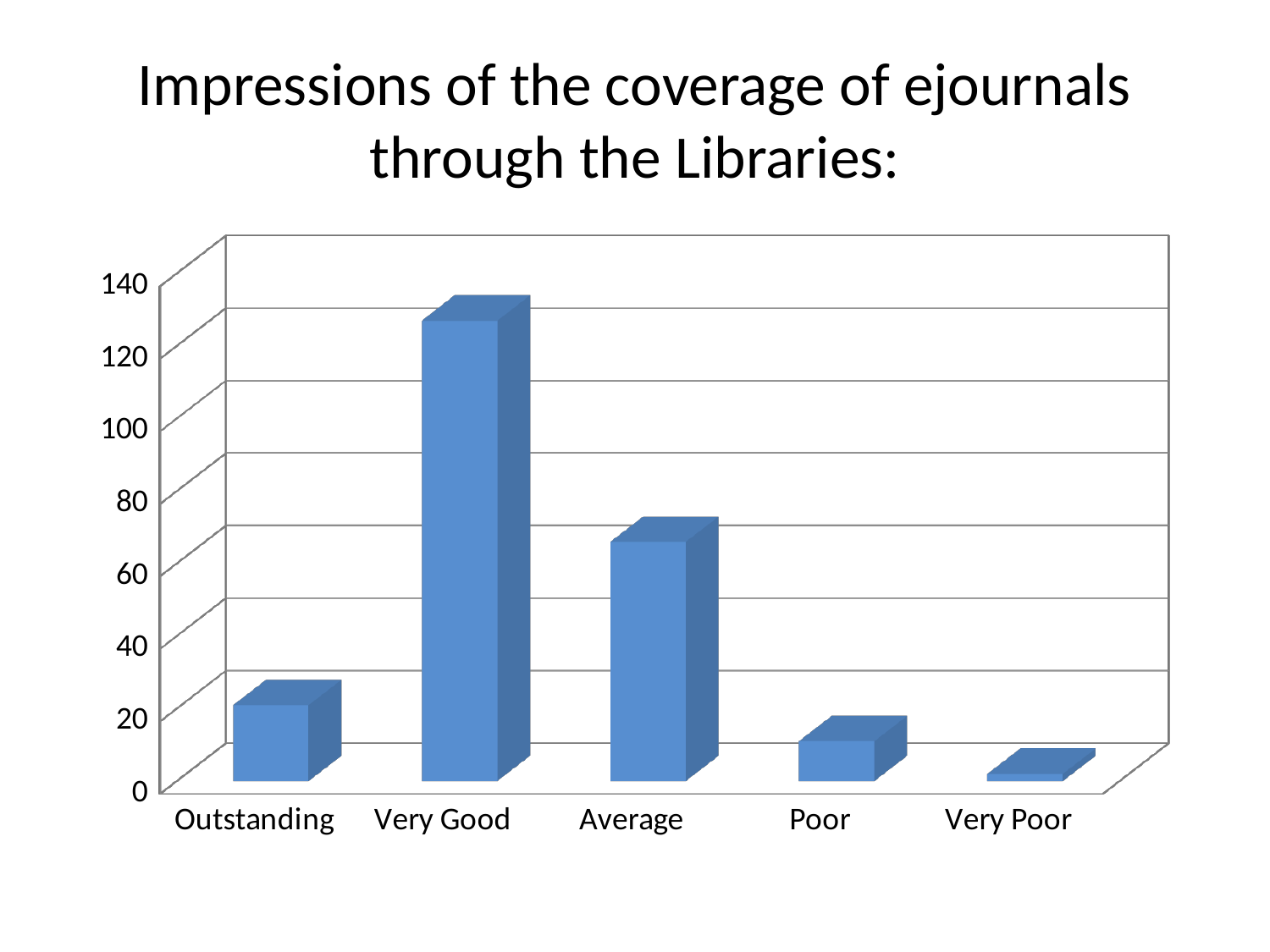
Is the value for Average greater or less than 80? less Which category has the lowest value? Very Poor What is the title of the chart? Impressions of the coverage of ejournals through the Libraries: Is the value for Average greater or less than 40? greater Is the value for Poor greater or less than 20? less Which is larger, the value for Average or the value for Outstanding? Average Which category has the highest value? Very Good What kind of chart is shown on the slide? bar chart Which is larger, the value for Poor or the value for Very Poor? Poor How many categories are shown on the x axis? 5